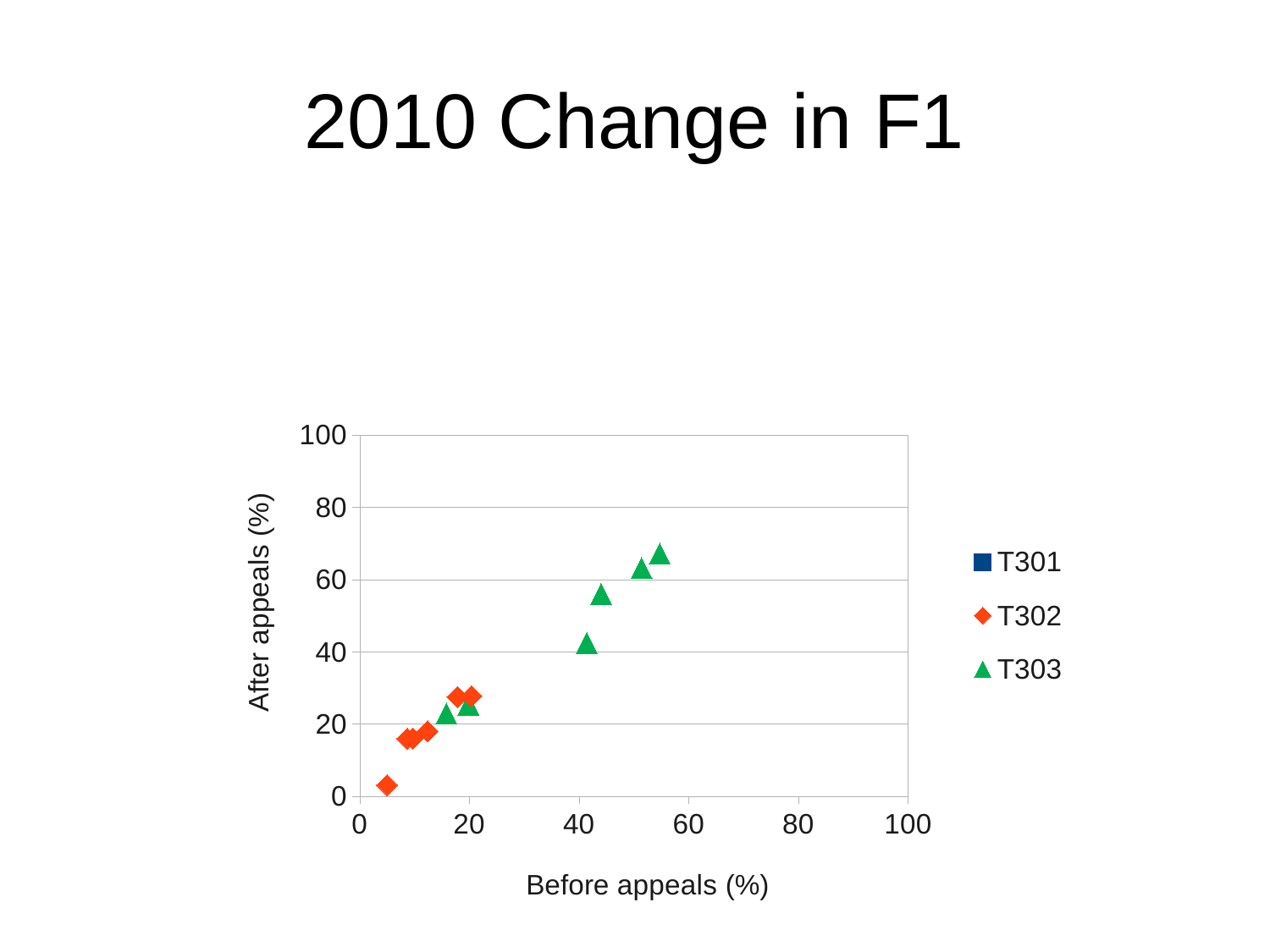
Is the lowest After appeals value for T302 greater or less than 20? less What kind of chart is shown on the slide? Scatter chart Is the largest Before appeals value for T302 greater or less than 40? less What is the title of the chart? 2010 Change in F1 What is the label of the horizontal axis? Before appeals (%) Which series has the point with the highest After appeals value? T303 Is any point plotted above 80 on the After appeals axis? No Which series reaches a larger Before appeals value, T302 or T303? T303 Which series has the point with the lowest After appeals value? T302 How many series does the legend list? 3 As Before appeals values increase, do the After appeals values generally rise or fall? rise